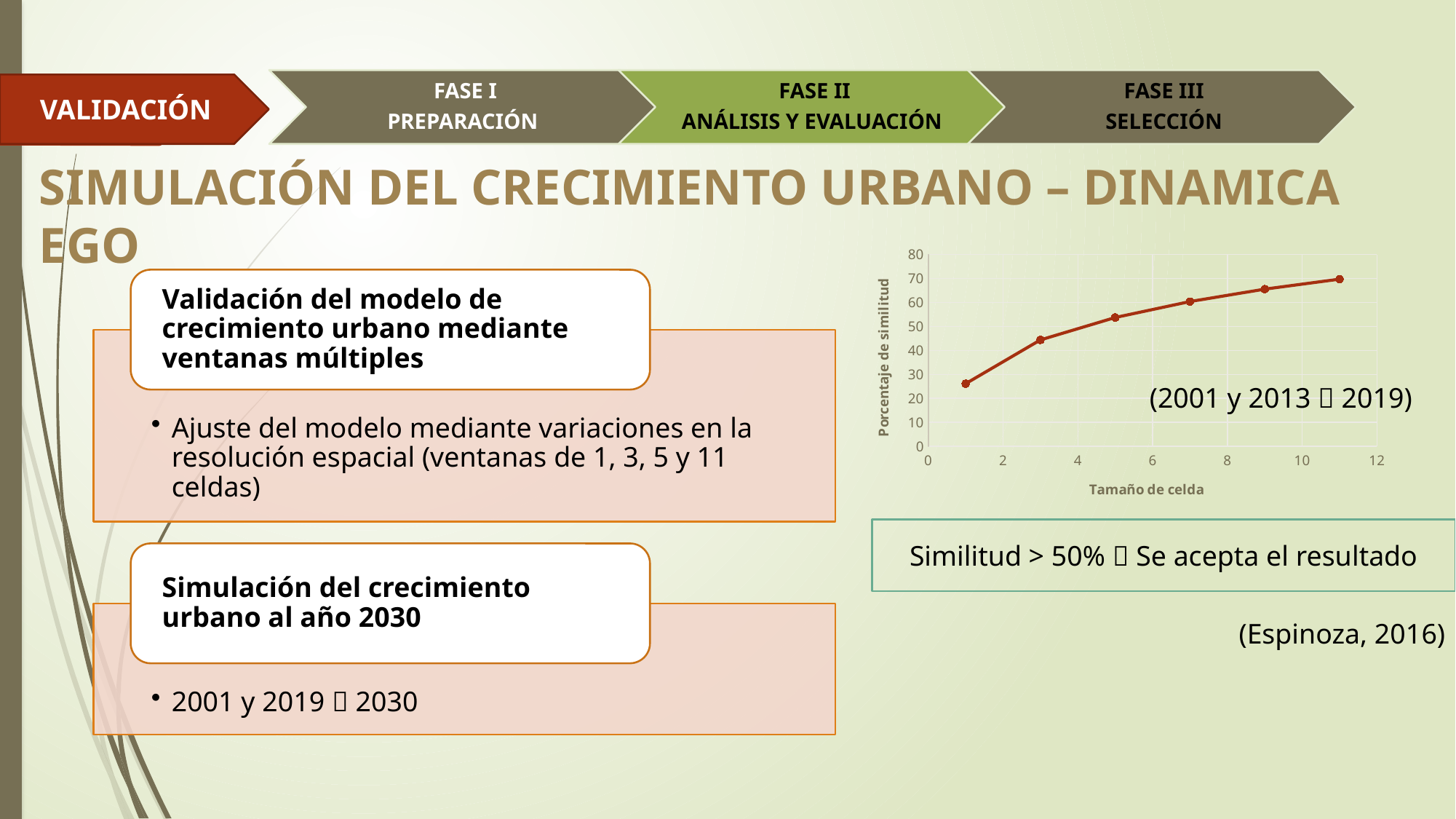
Which has a higher percentage of similarity, cell size 3 or cell size 9? cell size 9 Is the value for cell size 5 greater or less than 60? less Is the value for cell size 3 greater or less than 40? greater Is the value for cell size 1 greater or less than 30? less What kind of chart is shown on the slide? line chart What is the title of the x axis of the chart? Tamaño de celda How many data points are plotted on the line chart? 6 Do the values on the line chart rise or fall as the cell size (Tamaño de celda) increases? rise At which cell size is the percentage of similarity lowest? 1 What is the title of the y axis of the chart? Porcentaje de similitud At which cell size is the percentage of similarity highest? 11